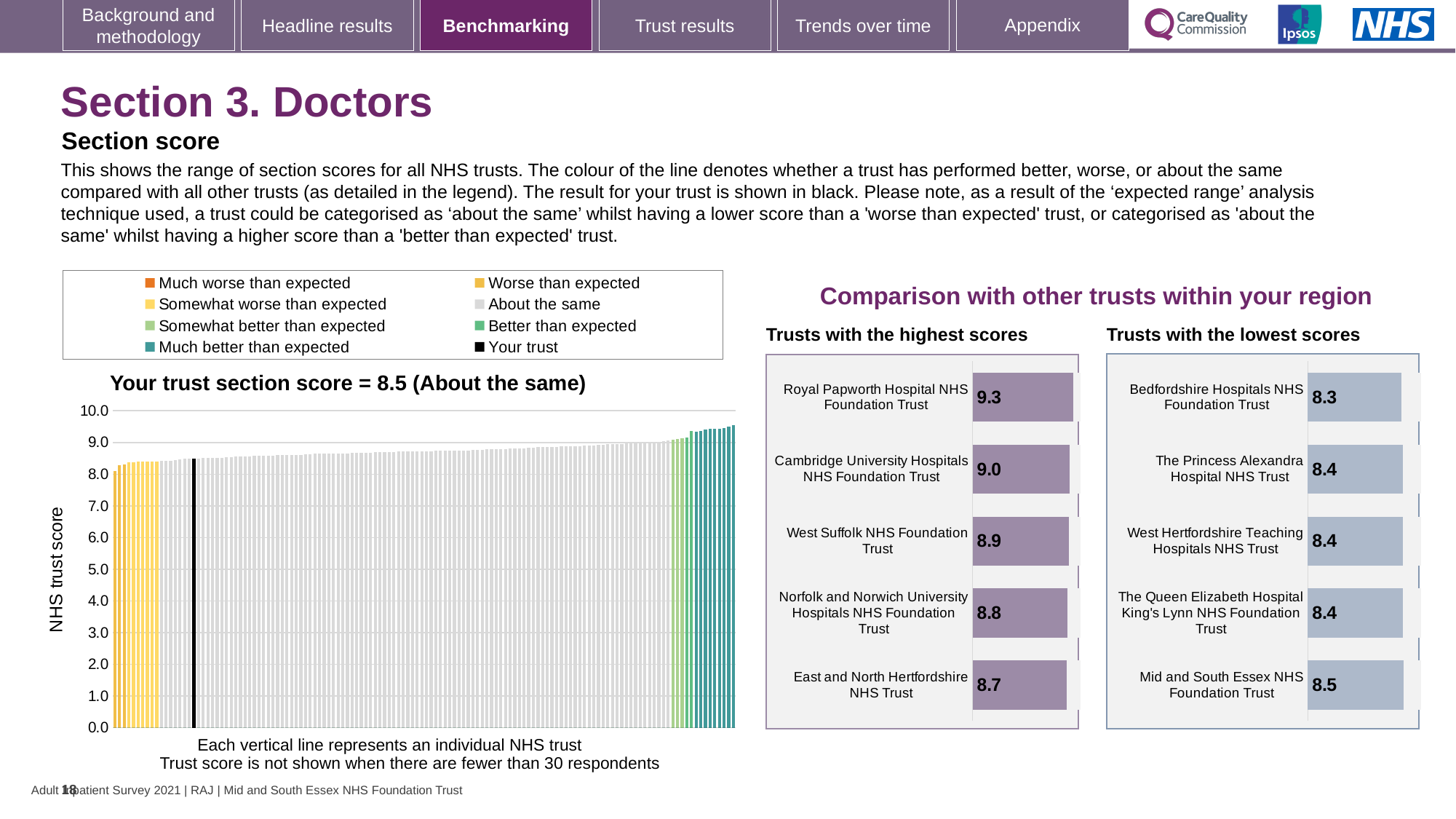
How many entries does the legend of the main section score chart on the left list? 8 In the 'Trusts with the highest scores' chart, what is the score for Royal Papworth Hospital NHS Foundation Trust? 9.3 In the 'Trusts with the highest scores' chart, what is the difference between the scores of Royal Papworth Hospital NHS Foundation Trust and East and North Hertfordshire NHS Trust? 0.6 In the main section score chart on the left, what is the section score for your trust? 8.5 In the 'Trusts with the highest scores' chart, which has the higher score: Cambridge University Hospitals NHS Foundation Trust or Norfolk and Norwich University Hospitals NHS Foundation Trust? Cambridge University Hospitals NHS Foundation Trust In the 'Trusts with the highest scores' chart, what is the score for West Suffolk NHS Foundation Trust? 8.9 In the 'Trusts with the lowest scores' chart, which trust has the highest score? Mid and South Essex NHS Foundation Trust In the 'Trusts with the lowest scores' chart, which trust has the lowest score? Bedfordshire Hospitals NHS Foundation Trust In the main section score chart on the left, do the trust scores rise or fall from left to right along the x axis? rise In the 'Trusts with the lowest scores' chart, what is the score for Bedfordshire Hospitals NHS Foundation Trust? 8.3 How many trusts are shown in the 'Trusts with the highest scores' chart? 5 In the main section score chart on the left, is the value for your trust (the black bar) greater or less than 8.0? greater